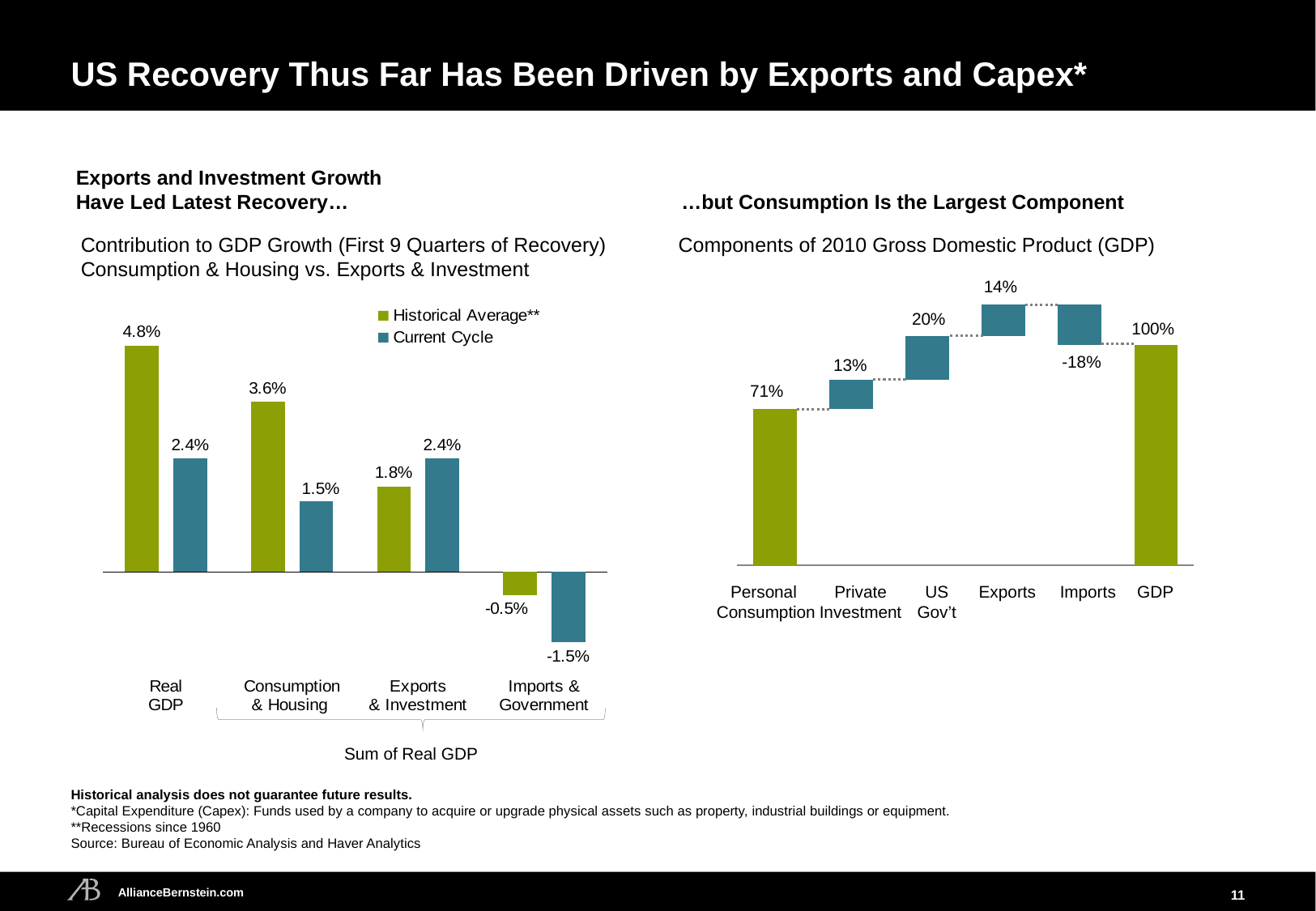
In the right chart (Components of 2010 GDP), what is the value for Personal Consumption? 71% In the left chart (Contribution to GDP Growth), which is larger for Exports & Investment: the Historical Average or the Current Cycle value? Current Cycle What kind of chart is the left chart (Contribution to GDP Growth)? Bar chart In the right chart (Components of 2010 GDP), how many categories are shown on the x axis? 6 In the left chart (Contribution to GDP Growth), how many series does the legend list? 2 In the left chart (Contribution to GDP Growth), what is the difference between the Historical Average and Current Cycle values for Consumption & Housing? 2.1% In the right chart (Components of 2010 GDP), which component other than GDP has the lowest value? Imports In the left chart (Contribution to GDP Growth), which category has the highest Historical Average value? Real GDP In the left chart (Contribution to GDP Growth), what is the Current Cycle value for Imports & Government? -1.5% In the left chart (Contribution to GDP Growth), what is the Current Cycle value for Exports & Investment? 2.4% In the left chart (Contribution to GDP Growth), what is the Historical Average value for Real GDP? 4.8% In the right chart (Components of 2010 GDP), what is the value for Imports? -18%